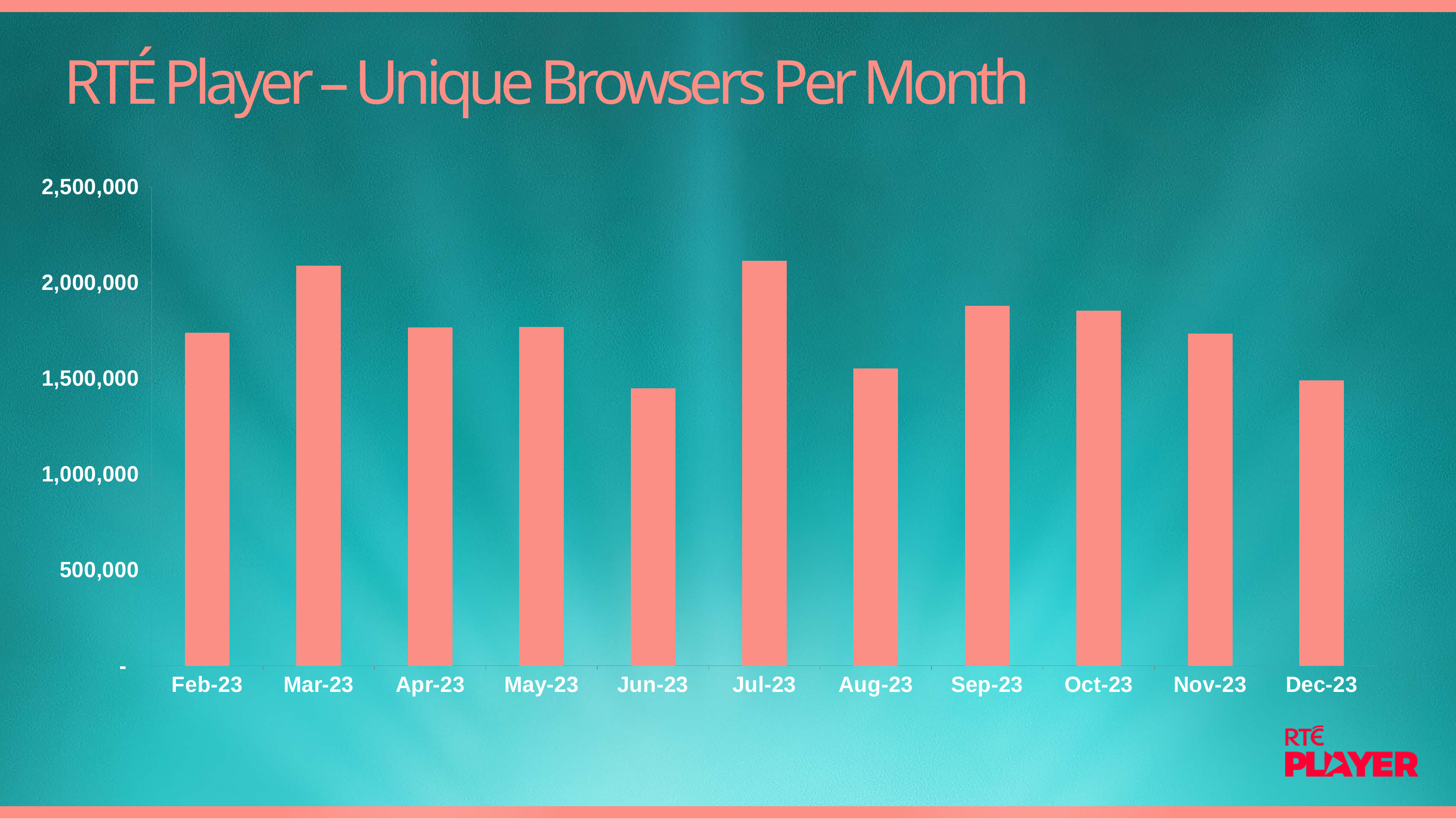
Is the value for Sep-23 greater or less than 2,000,000? less What is the title of the chart? RTÉ Player – Unique Browsers Per Month Which is larger, the value for Sep-23 or the value for Aug-23? Sep-23 What kind of chart is shown on the slide? bar chart Do the values rise or fall from Feb-23 to Mar-23? rise Which is larger, the value for Mar-23 or the value for Jun-23? Mar-23 Do the values rise or fall from Jul-23 to Aug-23? fall Is the value for Jun-23 greater or less than 1,500,000? less How many months are shown on the x axis of the chart? 11 Is the value for Feb-23 greater or less than 1,500,000? greater